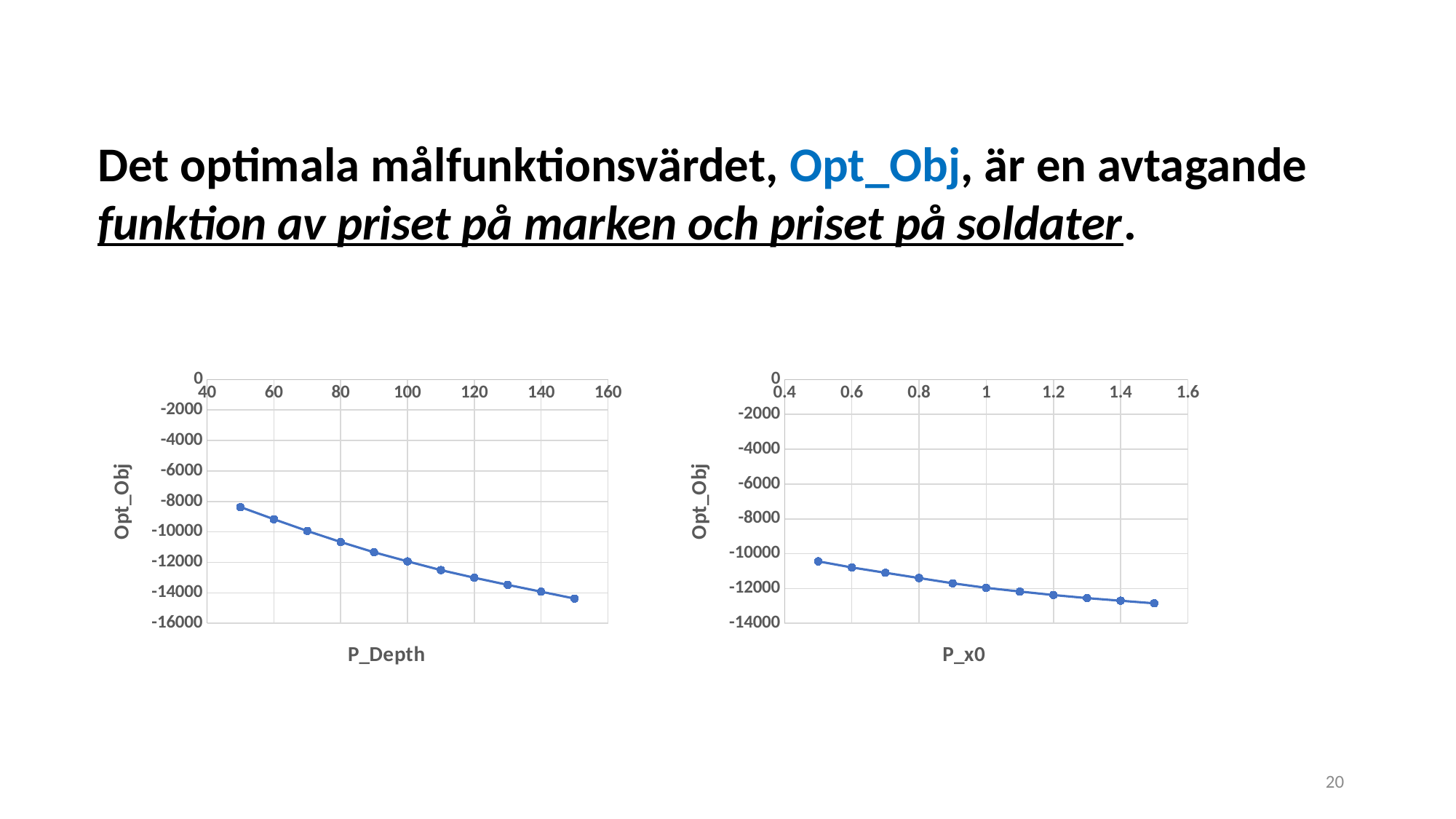
On the left chart (P_Depth), is the Opt_Obj value at P_Depth = 50 greater or less than -10000? greater On the right chart (P_x0), is the Opt_Obj value at P_x0 = 0.5 greater or less than -10000? less On the right chart (P_x0), do the Opt_Obj values rise or fall as P_x0 increases? fall On the right chart, what is the label of the x axis? P_x0 On the left chart (P_Depth), do the Opt_Obj values rise or fall as P_Depth increases? fall On the left chart (P_Depth), is the Opt_Obj value at P_Depth = 80 greater or less than -10000? less On the left chart (P_Depth), which P_Depth value has the highest Opt_Obj? 50 On the right chart (P_x0), how many data points are plotted? 11 On the left chart (P_Depth), what kind of chart is shown? line chart On the left chart (P_Depth), how many data points are plotted? 11